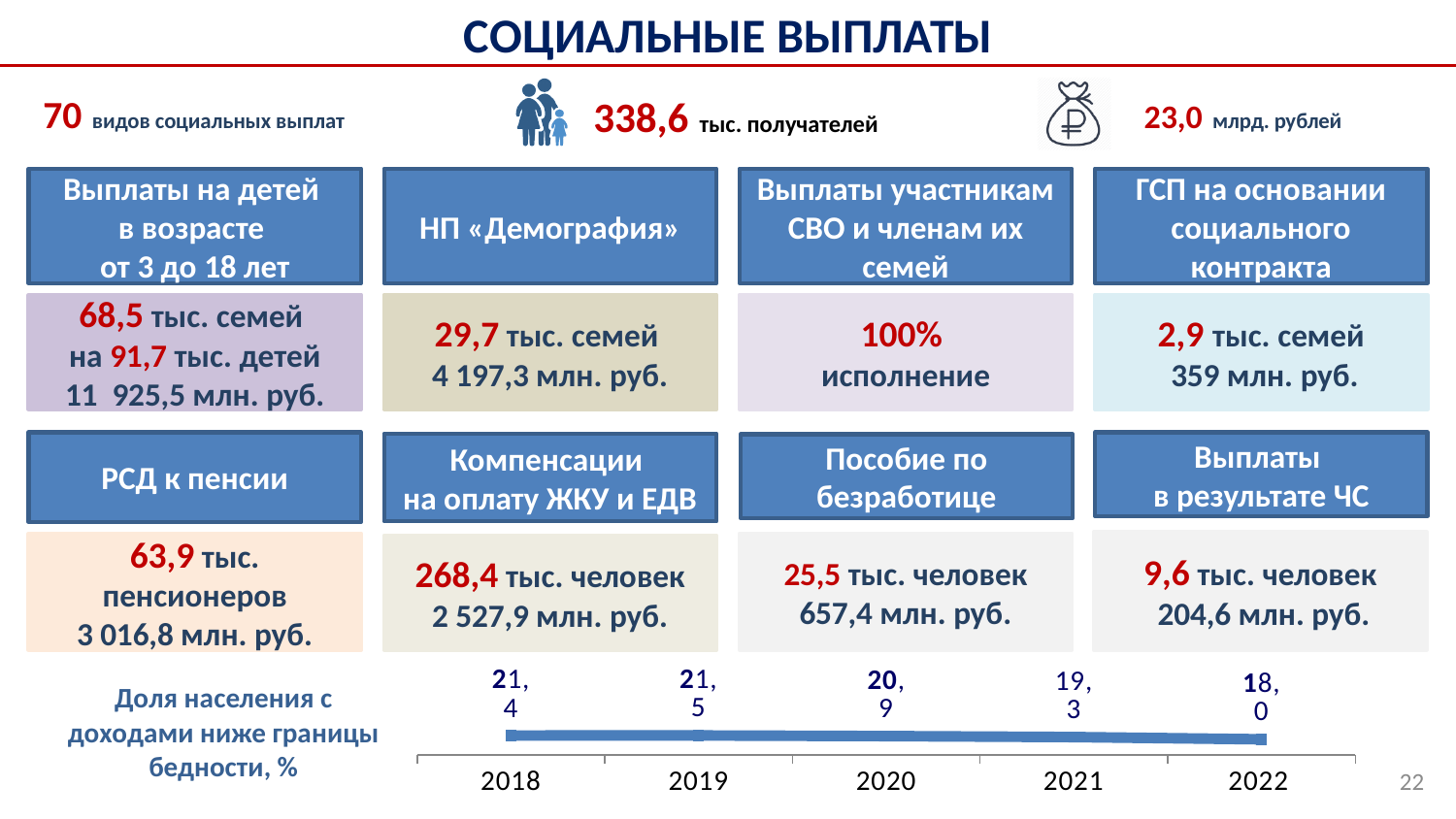
In the chart 'Доля населения с доходами ниже границы бедности, %', which year has the lowest value? 2022 In the chart 'Доля населения с доходами ниже границы бедности, %', what is the difference between the 2018 and 2022 values? 3,4 In the chart 'Доля населения с доходами ниже границы бедности, %', which year has the highest value? 2019 In the chart 'Доля населения с доходами ниже границы бедности, %', do the values generally rise or fall from 2019 to 2022? fall What kind of chart is used for 'Доля населения с доходами ниже границы бедности, %'? line chart How many years are plotted in the chart 'Доля населения с доходами ниже границы бедности, %'? 5 What is the value for 2021 in the chart 'Доля населения с доходами ниже границы бедности, %'? 19,3 What is the value for 2022 in the chart 'Доля населения с доходами ниже границы бедности, %'? 18,0 What is the value for 2020 in the chart 'Доля населения с доходами ниже границы бедности, %'? 20,9 In the chart 'Доля населения с доходами ниже границы бедности, %', what is the difference between the 2021 and 2022 values? 1,3 In the chart 'Доля населения с доходами ниже границы бедности, %', which is larger: the value for 2020 or the value for 2021? 2020 What is the value for 2018 in the chart 'Доля населения с доходами ниже границы бедности, %'? 21,4